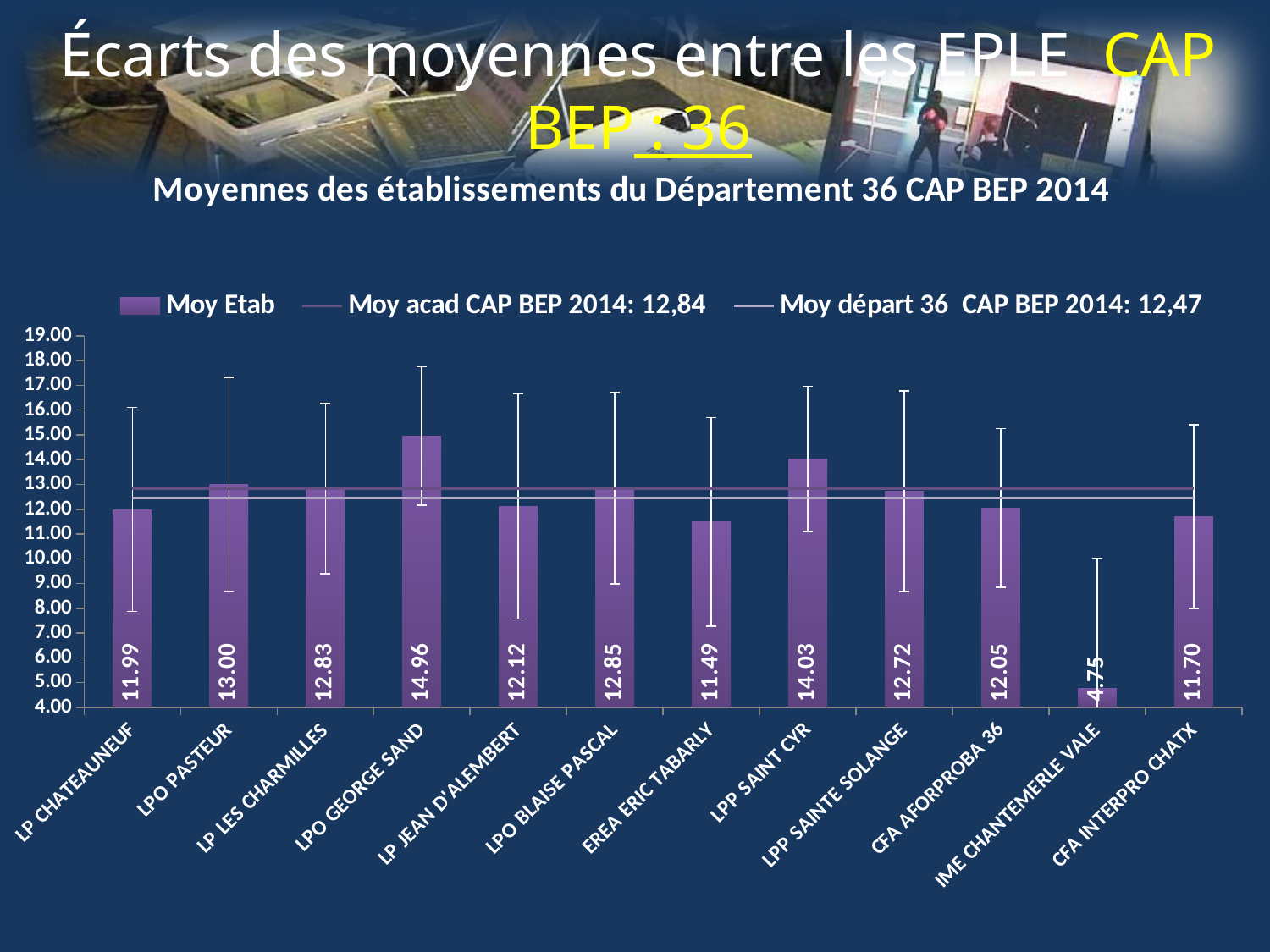
What is the difference between the values for LPO GEORGE SAND and IME CHANTEMERLE VALE? 10.21 What is the difference between the values for LPP SAINT CYR and LPO PASTEUR? 1.03 What is the value for EREA ERIC TABARLY? 11.49 How many establishments are shown on the x axis? 12 Which is larger, the value for LPP SAINT CYR or the value for LP CHATEAUNEUF? LPP SAINT CYR Which establishment has the highest value? LPO GEORGE SAND What kind of chart is shown on the slide? combination bar and line chart How many series does the legend list? 3 Is the value for IME CHANTEMERLE VALE greater or less than 10.00? less Which establishment has the lowest value? IME CHANTEMERLE VALE What is the value for CFA INTERPRO CHATX? 11.70 What is the value for LPO GEORGE SAND? 14.96